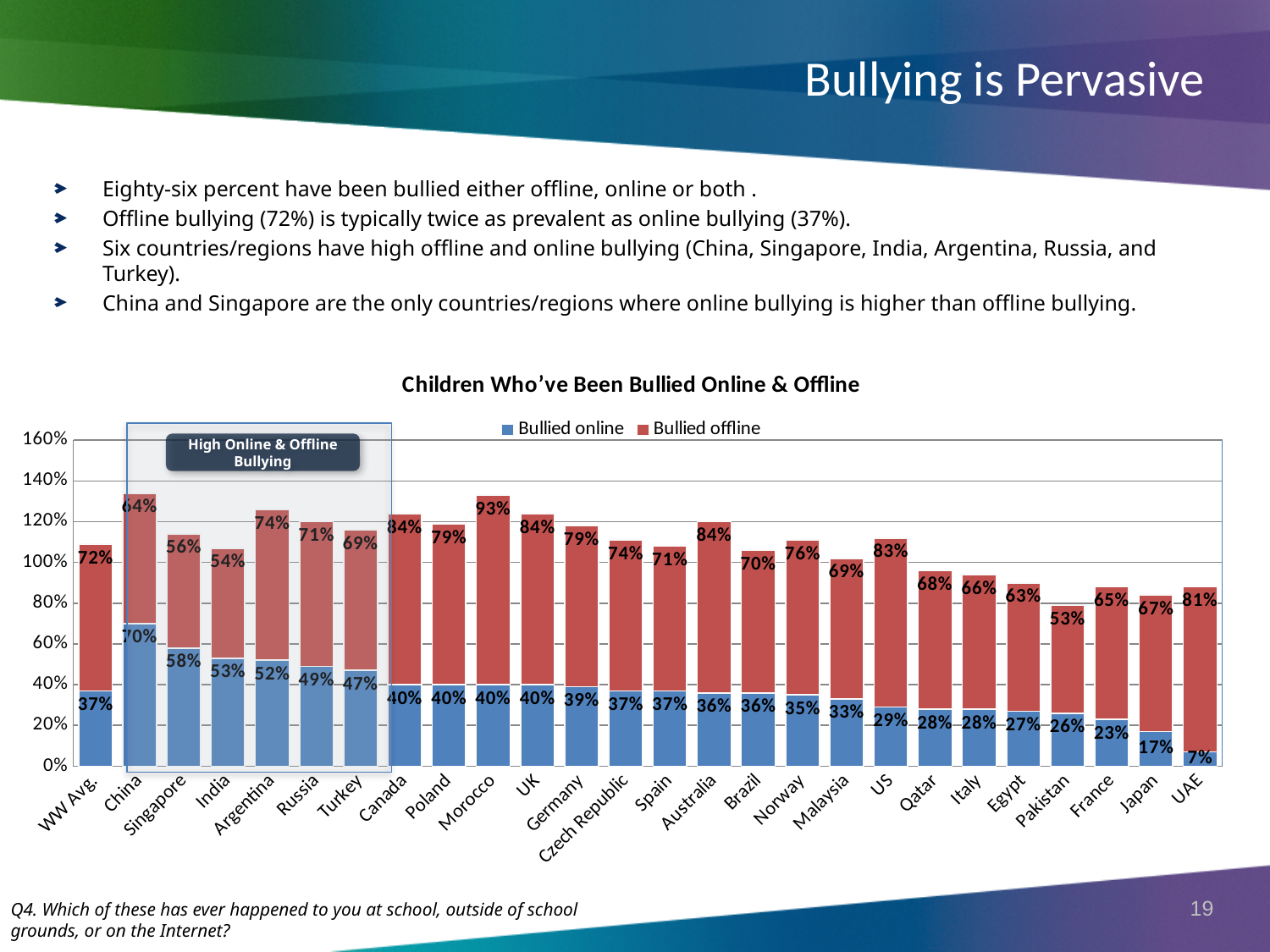
How many series does the legend list? 2 What kind of chart is shown on the slide? Stacked bar chart Which has a higher Bullied online value, Japan or France? France Which country/region has the lowest Bullied online value? UAE What is the Bullied online value for China? 70% What is the total of the stacked bar for WW Avg? 109% What is the Bullied online value for UAE? 7% Which country/region has the highest Bullied online value? China Which country/region has the highest Bullied offline value? Morocco What is the Bullied offline value for Morocco? 93% How many countries/regions (including WW Avg) are shown on the x axis? 26 What is the difference between the Bullied online and Bullied offline values for China? 6%